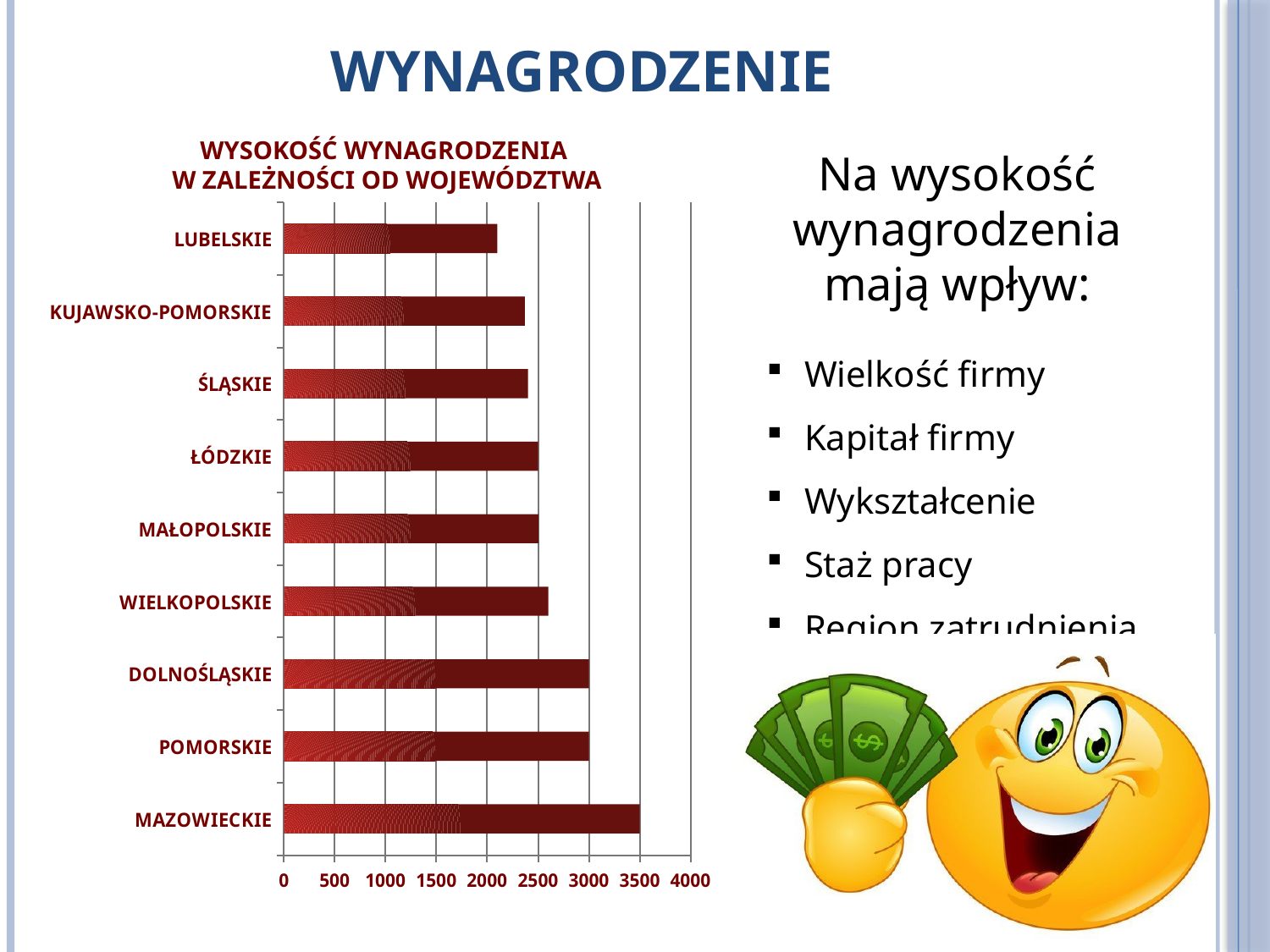
Which is larger, the value for POMORSKIE or the value for LUBELSKIE? POMORSKIE Is the value for LUBELSKIE greater or less than 2500? less What is the title of the chart? WYSOKOŚĆ WYNAGRODZENIA W ZALEŻNOŚCI OD WOJEWÓDZTWA Is the value for WIELKOPOLSKIE greater or less than 2500? greater Which voivodeship has the highest wage in the chart? MAZOWIECKIE Which is larger, the value for WIELKOPOLSKIE or the value for ŚLĄSKIE? WIELKOPOLSKIE What kind of chart is shown on the slide? bar chart What is the value for DOLNOŚLĄSKIE? 3000 Is the value for ŚLĄSKIE greater or less than 3000? less Which voivodeship has the lowest wage in the chart? LUBELSKIE What is the value for MAZOWIECKIE? 3500 How many voivodeships (categories) are shown in the chart? 9